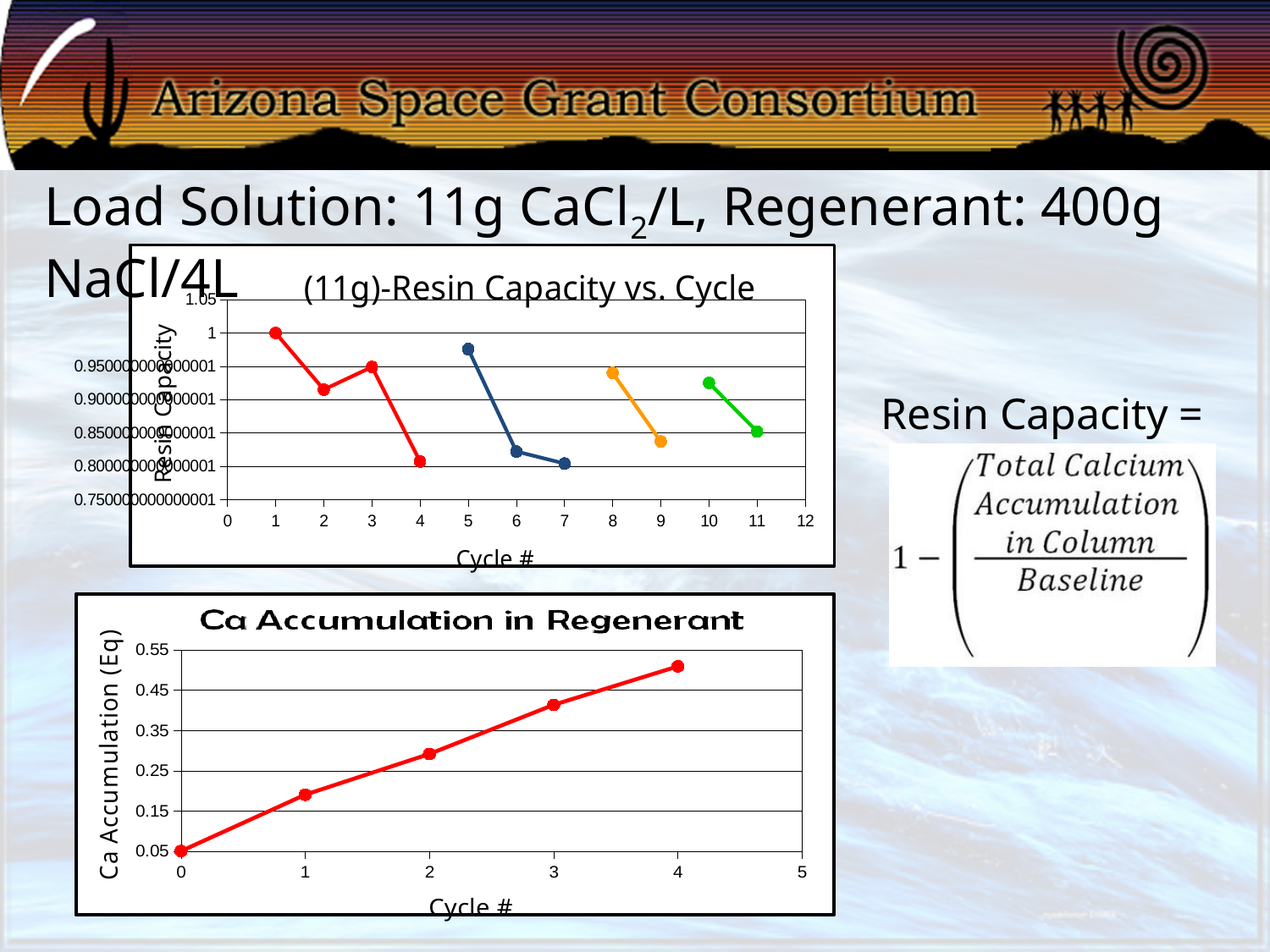
What kind of chart is the top chart titled "(11g)-Resin Capacity vs. Cycle"? line chart In the top chart "(11g)-Resin Capacity vs. Cycle", is the resin capacity at cycle 4 greater or less than 0.85? less In the bottom chart "Ca Accumulation in Regenerant", do the values rise or fall as the cycle number increases? rise What kind of chart is the bottom chart titled "Ca Accumulation in Regenerant"? line chart In the bottom chart "Ca Accumulation in Regenerant", is the value at cycle 4 greater or less than 0.45? greater In the bottom chart "Ca Accumulation in Regenerant", is the value at cycle 1 greater or less than 0.25? less What is the x-axis title of the top chart "(11g)-Resin Capacity vs. Cycle"? Cycle # In the top chart "(11g)-Resin Capacity vs. Cycle", which has the higher resin capacity, cycle 5 or cycle 6? cycle 5 In the top chart "(11g)-Resin Capacity vs. Cycle", what is the resin capacity at cycle 1? 1 In the bottom chart "Ca Accumulation in Regenerant", which cycle has the highest Ca accumulation? 4 In the bottom chart "Ca Accumulation in Regenerant", how many data points are plotted? 5